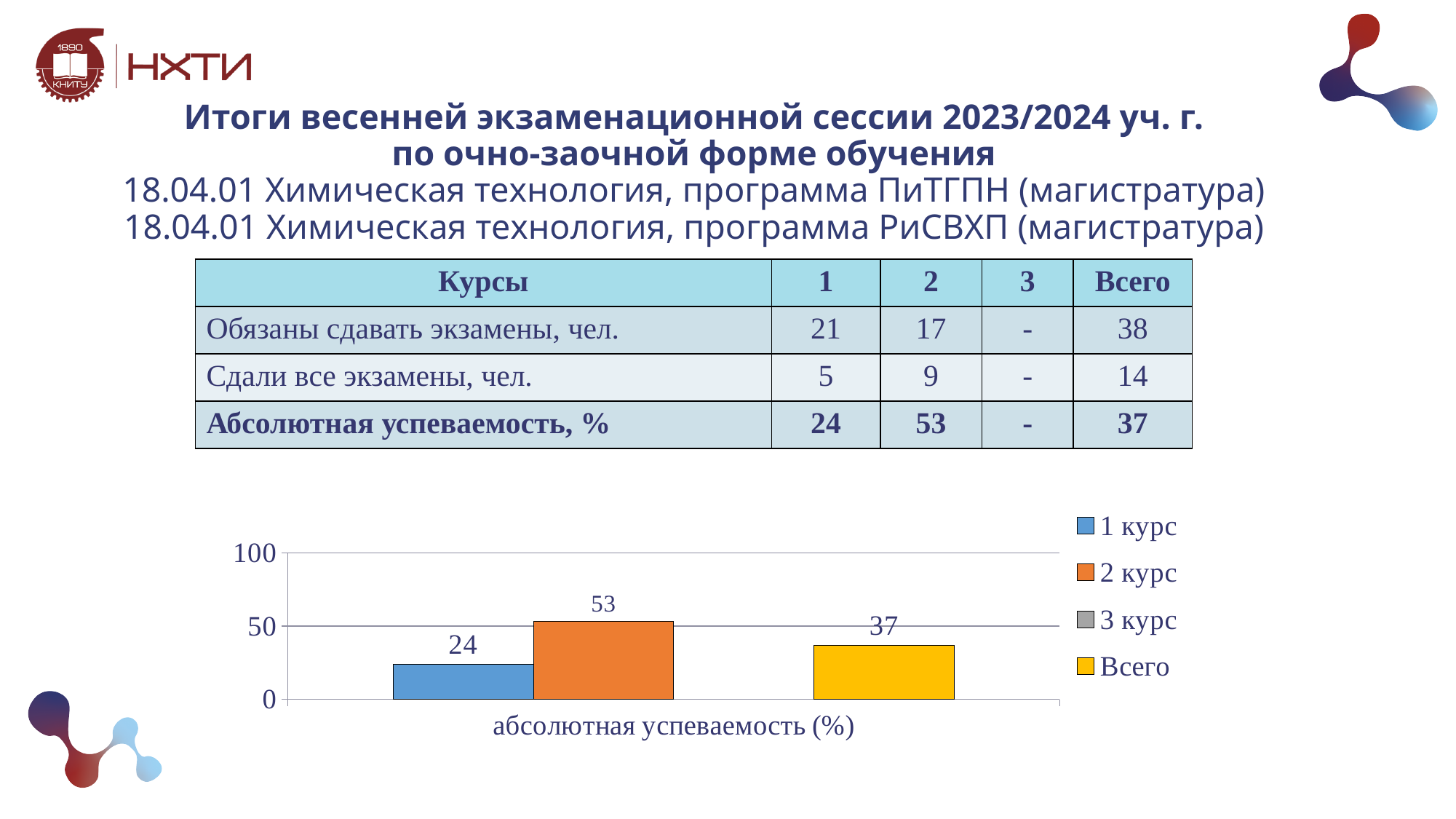
What is the label on the x axis of the chart? абсолютная успеваемость (%) Which series has the highest value in the chart? 2 курс What is the value for Всего in the chart? 37 What kind of chart is shown on the slide? bar chart How many series does the legend list? 4 What is the value for 2 курс in the chart? 53 Which is larger, the value for Всего or the value for 1 курс? Всего Is the value for Всего greater or less than 50? less Is the value for 2 курс greater or less than 50? greater What is the difference between the values for 2 курс and 1 курс? 29 Which plotted series has the lowest value in the chart? 1 курс What is the value for 1 курс in the chart? 24